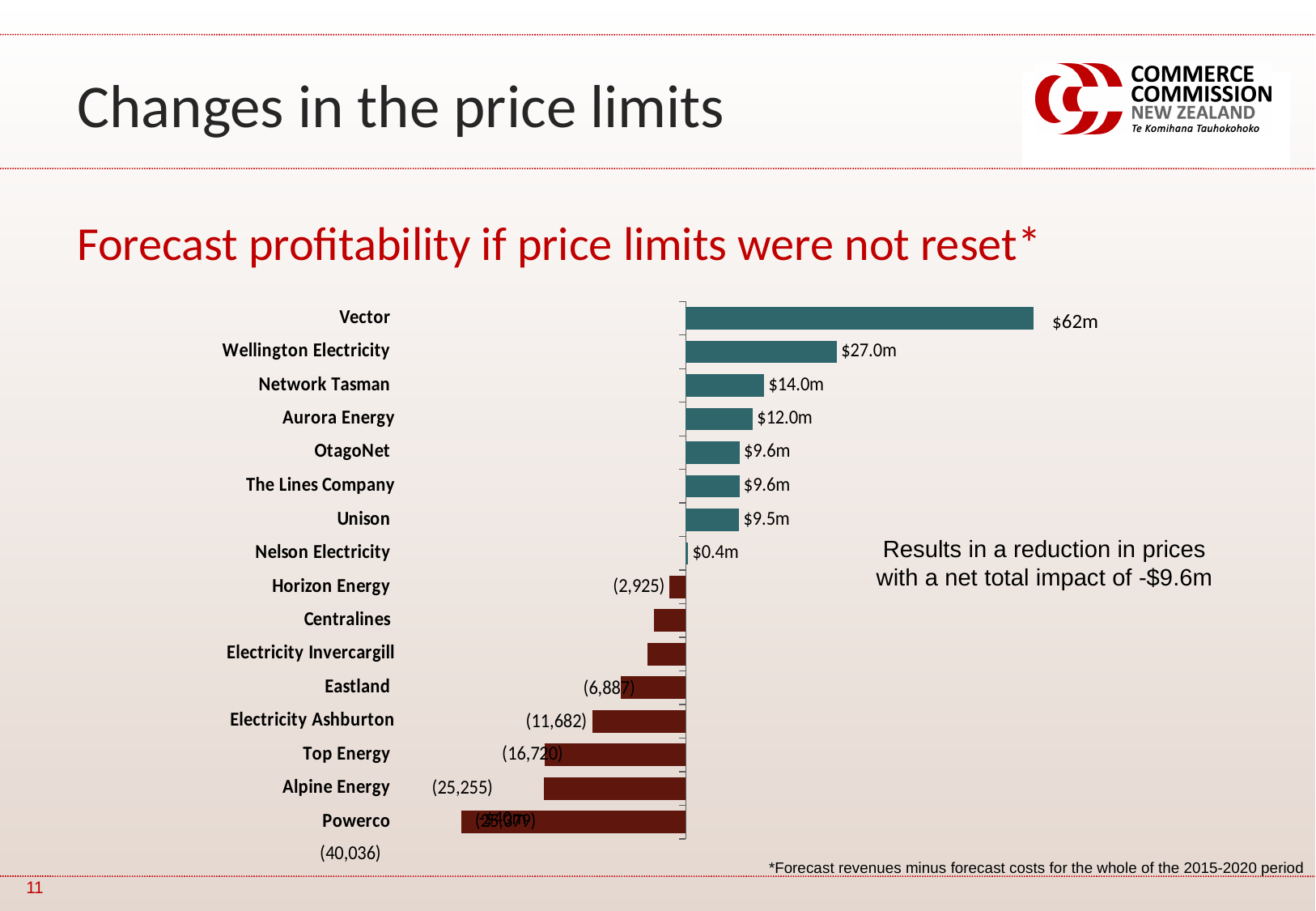
Which has the larger value, Network Tasman or Unison? Network Tasman What is the forecast profitability value shown for Vector? $62m Which company has the highest forecast profitability in the chart? Vector What is the value shown for Aurora Energy? $12.0m What is the value shown for Nelson Electricity? $0.4m What kind of chart is shown on the slide? bar chart Which company has the lowest (most negative) forecast profitability in the chart? Powerco What is the title of the chart? Forecast profitability if price limits were not reset What is the difference between the values for Vector and Wellington Electricity? $35m How many companies are listed in the chart? 16 What is the value shown for Wellington Electricity? $27.0m What is the difference between the values for Wellington Electricity and Network Tasman? $13.0m